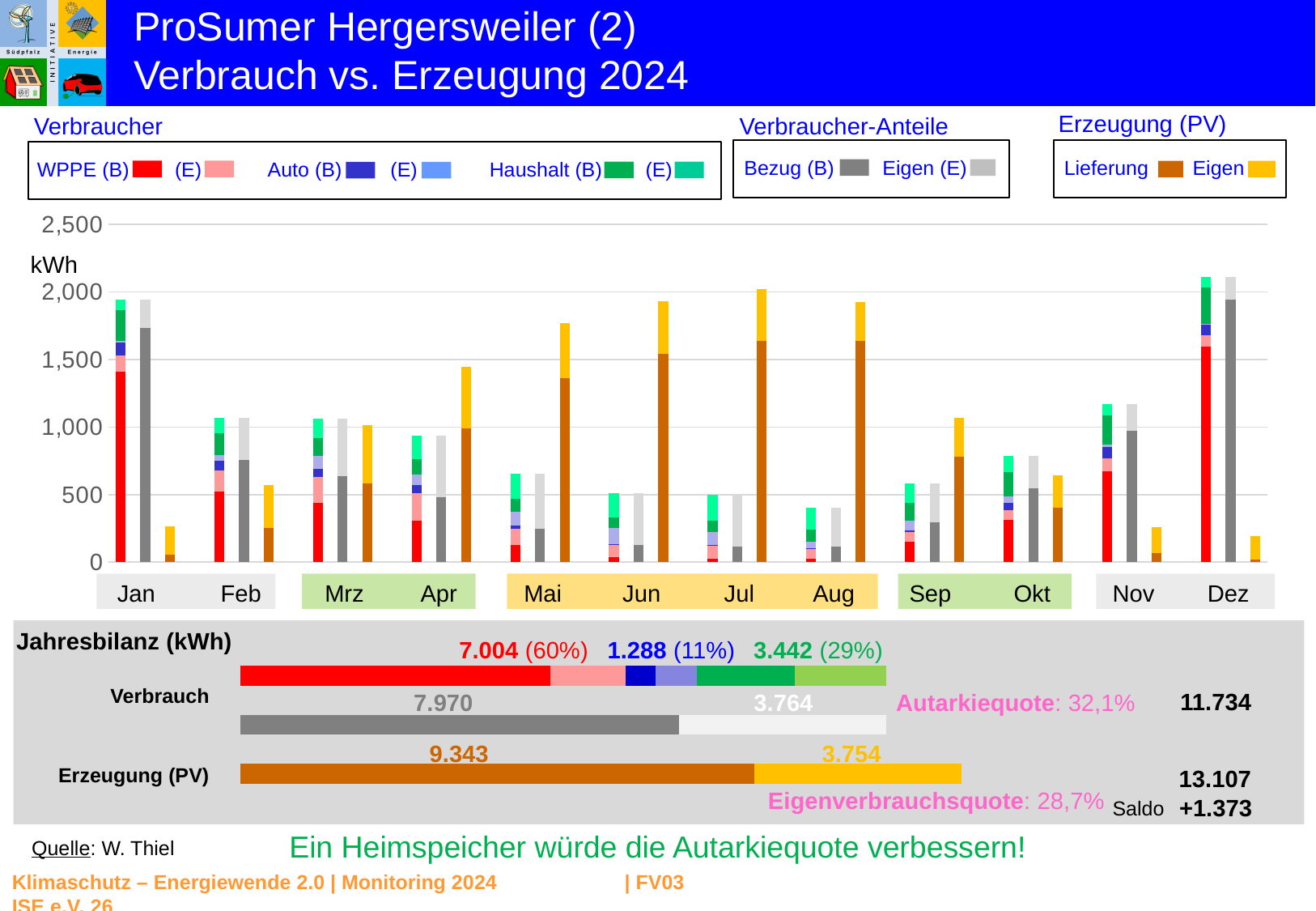
What kind of chart is used to show the monthly Verbrauch and Erzeugung values? bar chart Which month has the lowest total Verbrauch bar in the monthly chart? Aug In the Jahresbilanz, what is the total Verbrauch in kWh? 11.734 Is the Erzeugung (PV) bar for Jul greater or less than 1,500 kWh? greater How many entries does the Erzeugung (PV) legend list? 2 Is the Erzeugung (PV) bar for Feb greater or less than 1,000 kWh? less Which month has the highest total Verbrauch bar in the monthly chart? Dez How many months are shown on the x axis of the monthly chart? 12 In the Jahresbilanz, what is the Autarkiequote? 32,1% In the Jahresbilanz, which is larger: Bezug (B) or Eigen (E) for Verbrauch? Bezug (B) Is the total Verbrauch bar for Jan greater or less than 1,500 kWh? greater In the Jahresbilanz, what is the difference between Lieferung (9.343) and Eigen (3.754) for Erzeugung (PV)? 5.589